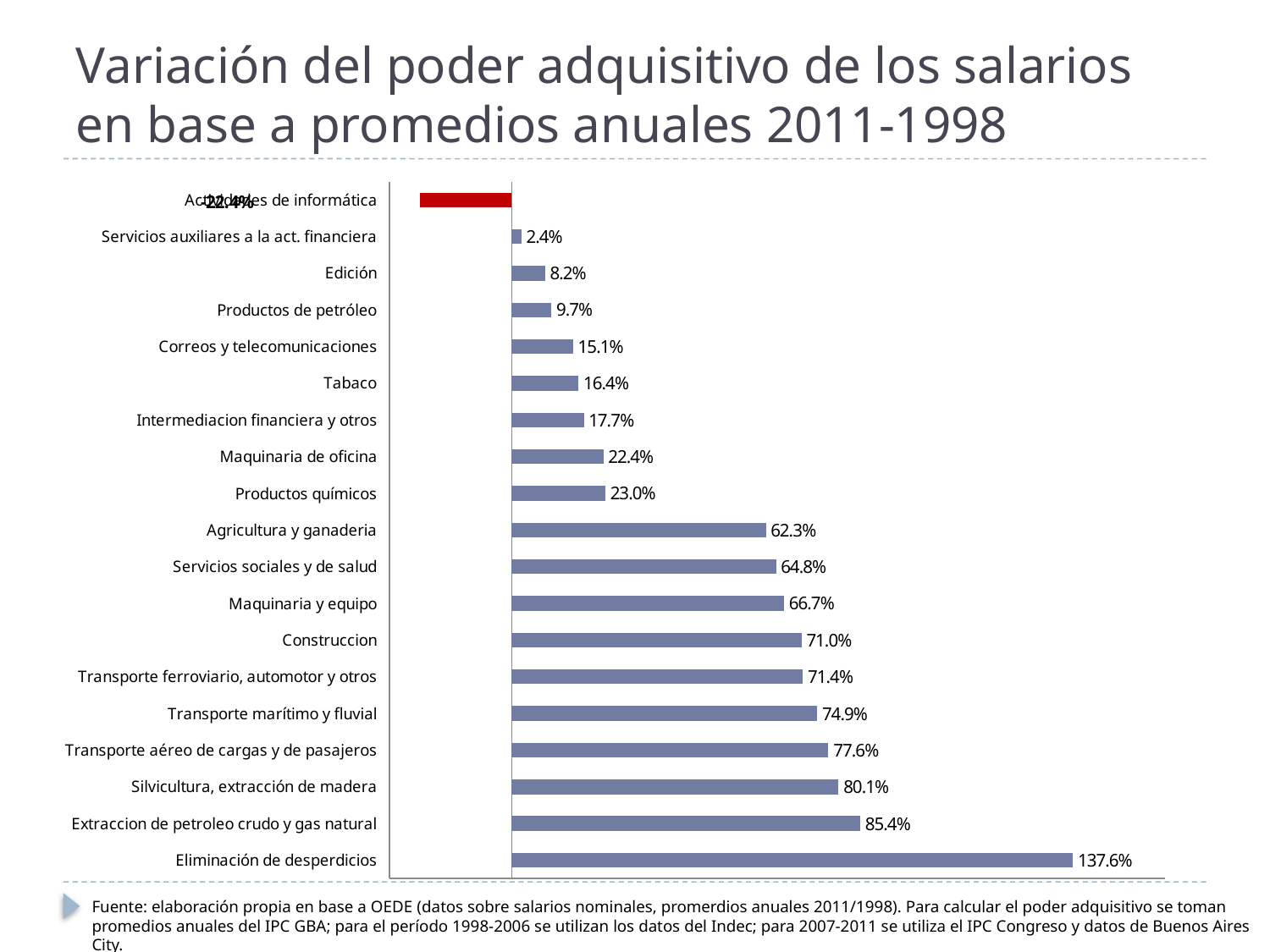
What kind of chart is shown on the slide? Bar chart How many categories are shown in the chart? 19 What is the difference between Eliminación de desperdicios and Extraccion de petroleo crudo y gas natural? 52.2% What is the value for Construccion? 71.0% What is the value for Servicios auxiliares a la act. financiera? 2.4% What is the value for Silvicultura, extracción de madera? 80.1% Which category has the highest value? Eliminación de desperdicios What is the value for Eliminación de desperdicios? 137.6% Which is larger, Tabaco or Correos y telecomunicaciones? Tabaco Which category has the lowest value? Actividades de informática What is the difference between Agricultura y ganaderia and Productos químicos? 39.3% Which category's bar is coloured red? Actividades de informática